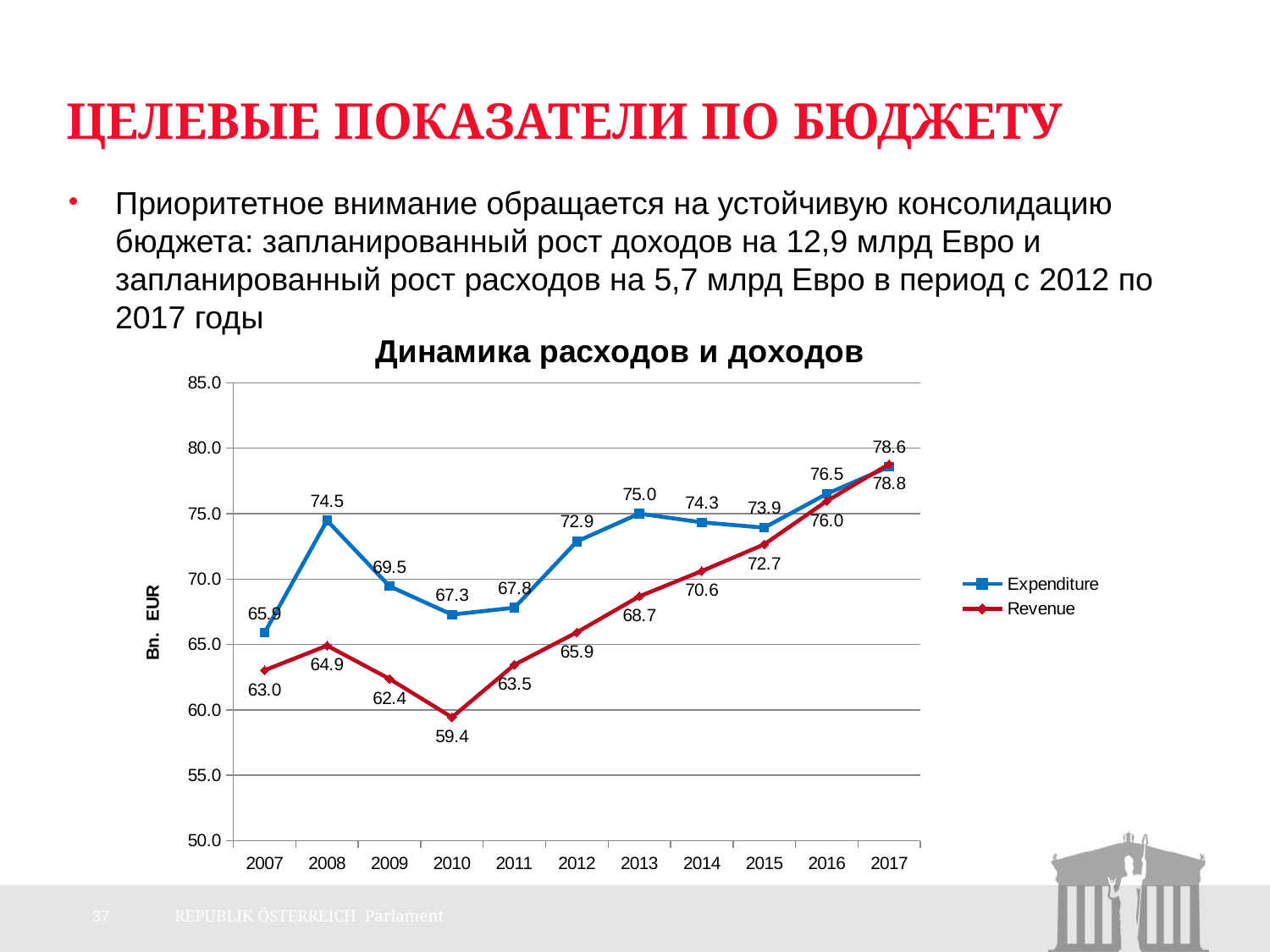
How many years are shown on the x axis? 11 In which year is Revenue lowest? 2010 In which year is Expenditure highest? 2017 Which is larger in 2013, Expenditure or Revenue? Expenditure What is the Revenue value for 2014? 70.6 What is the difference between Expenditure and Revenue in 2012? 7.0 What type of chart is shown on the slide? line chart What is the title of the chart? Динамика расходов и доходов How many series does the legend list? 2 What is the Expenditure value for 2008? 74.5 What is the Revenue value for 2010? 59.4 Does Revenue rise or fall from 2010 to 2017? rise